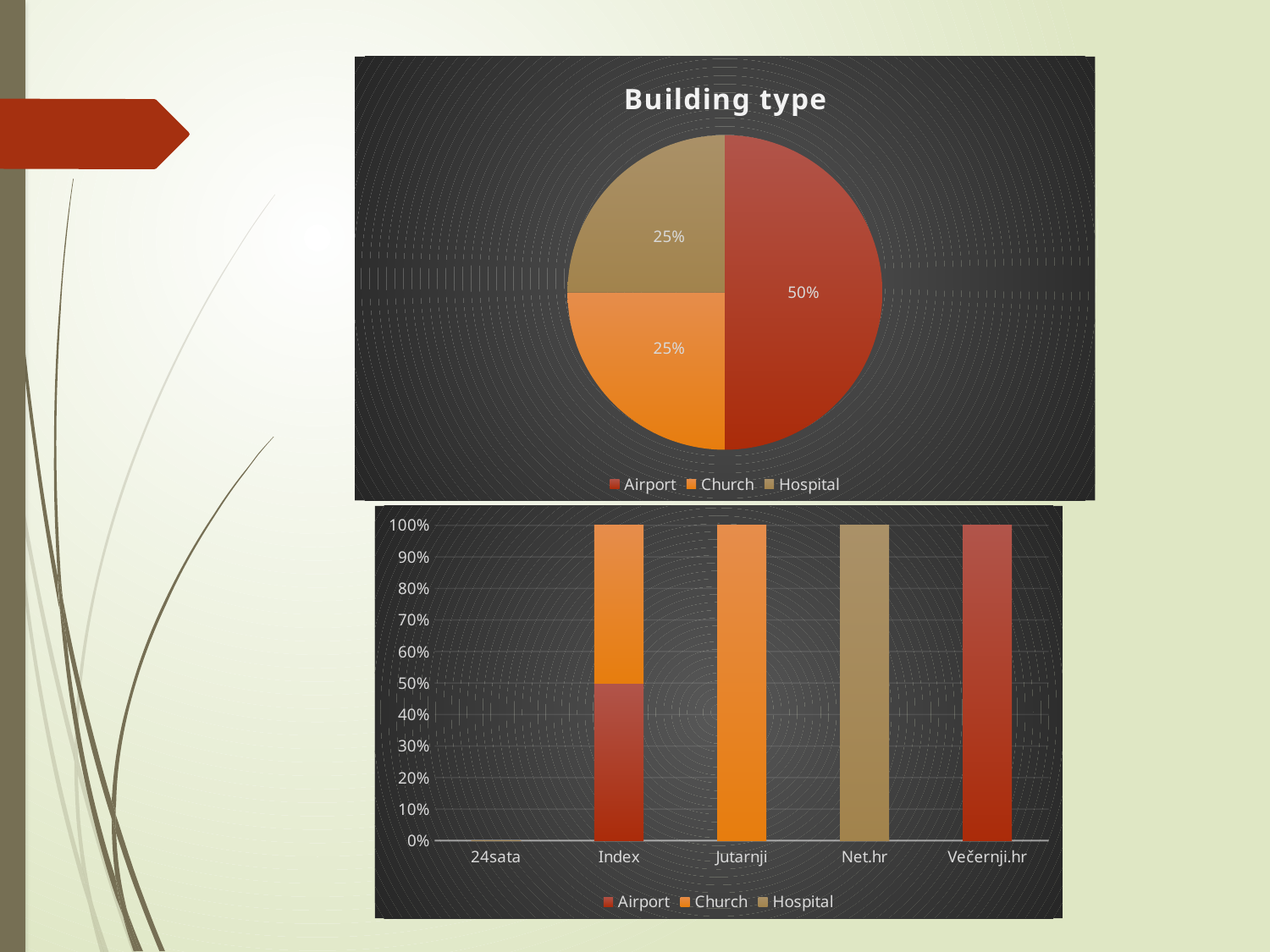
In the pie chart titled "Building type", which building type has the largest slice? Airport In the lower bar chart, how many series does the legend list? 3 In the pie chart titled "Building type", what is the difference between the Airport share and the Hospital share? 25% In the pie chart titled "Building type", what share does Airport have? 50% In the lower bar chart, which category has no bar at all? 24sata What kind of chart is the upper chart titled "Building type"? Pie chart In the lower bar chart, which series makes up the entire bar for Net.hr? Hospital In the lower bar chart, how many categories are shown on the x axis? 5 In the pie chart titled "Building type", what share does Church have? 25% In the lower bar chart, what is the Airport value for Index? 50% What kind of chart is the lower chart on the slide? Bar chart In the pie chart titled "Building type", how many slices are there? 3